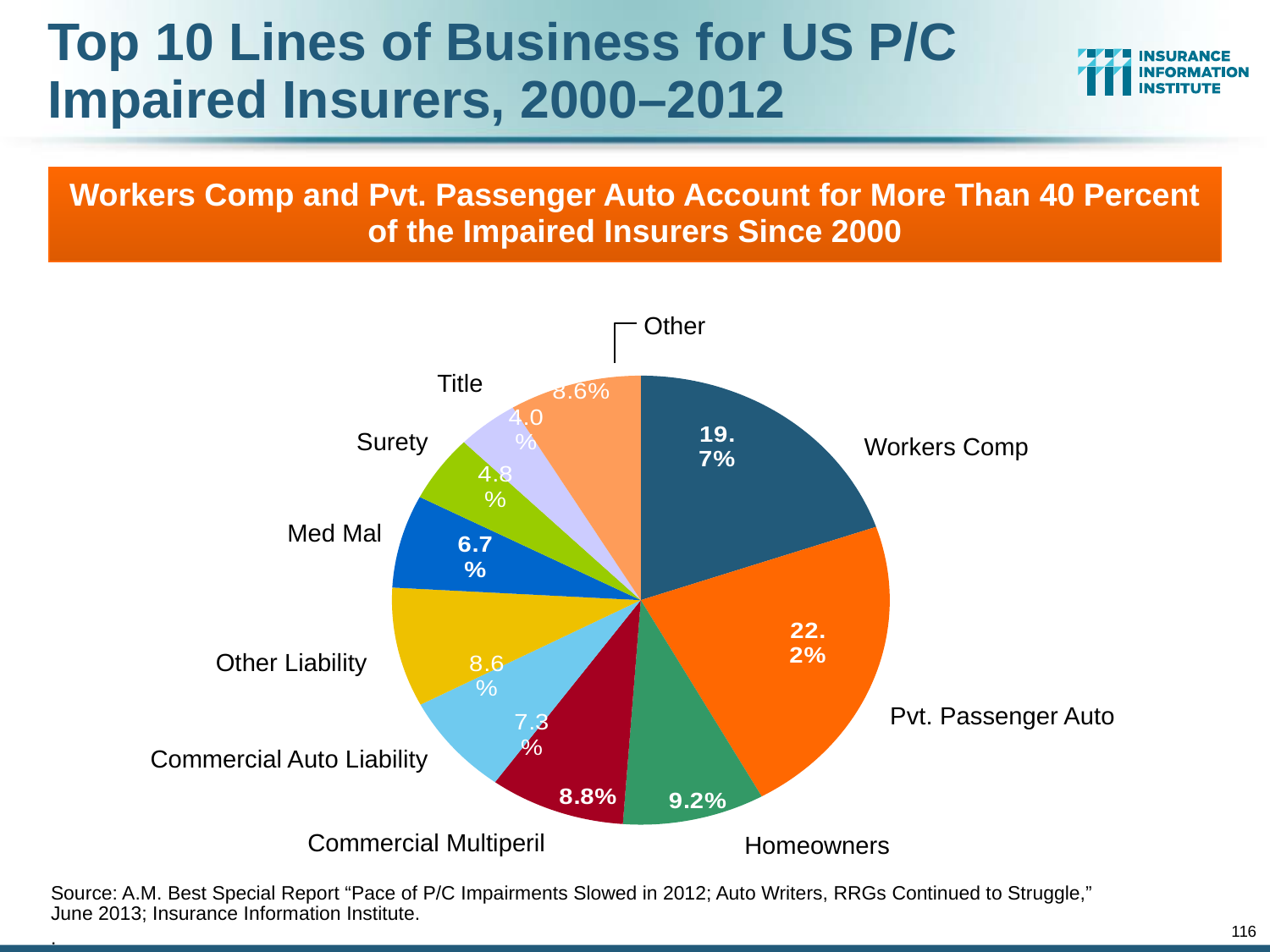
What is the difference between the Pvt. Passenger Auto share and the Workers Comp share? 2.5% Which line of business has the largest slice of the pie? Pvt. Passenger Auto What is the combined share of Workers Comp and Pvt. Passenger Auto? 41.9% Which is larger, the share for Commercial Multiperil or the share for Commercial Auto Liability? Commercial Multiperil How many slices does the pie chart have? 10 What kind of chart is shown on the slide? Pie chart What is the value shown for Title? 4.0% Which line of business has the smallest slice of the pie? Title What share of impaired insurers is attributed to Workers Comp? 19.7% What is the value shown for Homeowners? 9.2% What is the value shown for Med Mal? 6.7% What share of impaired insurers is attributed to Pvt. Passenger Auto? 22.2%